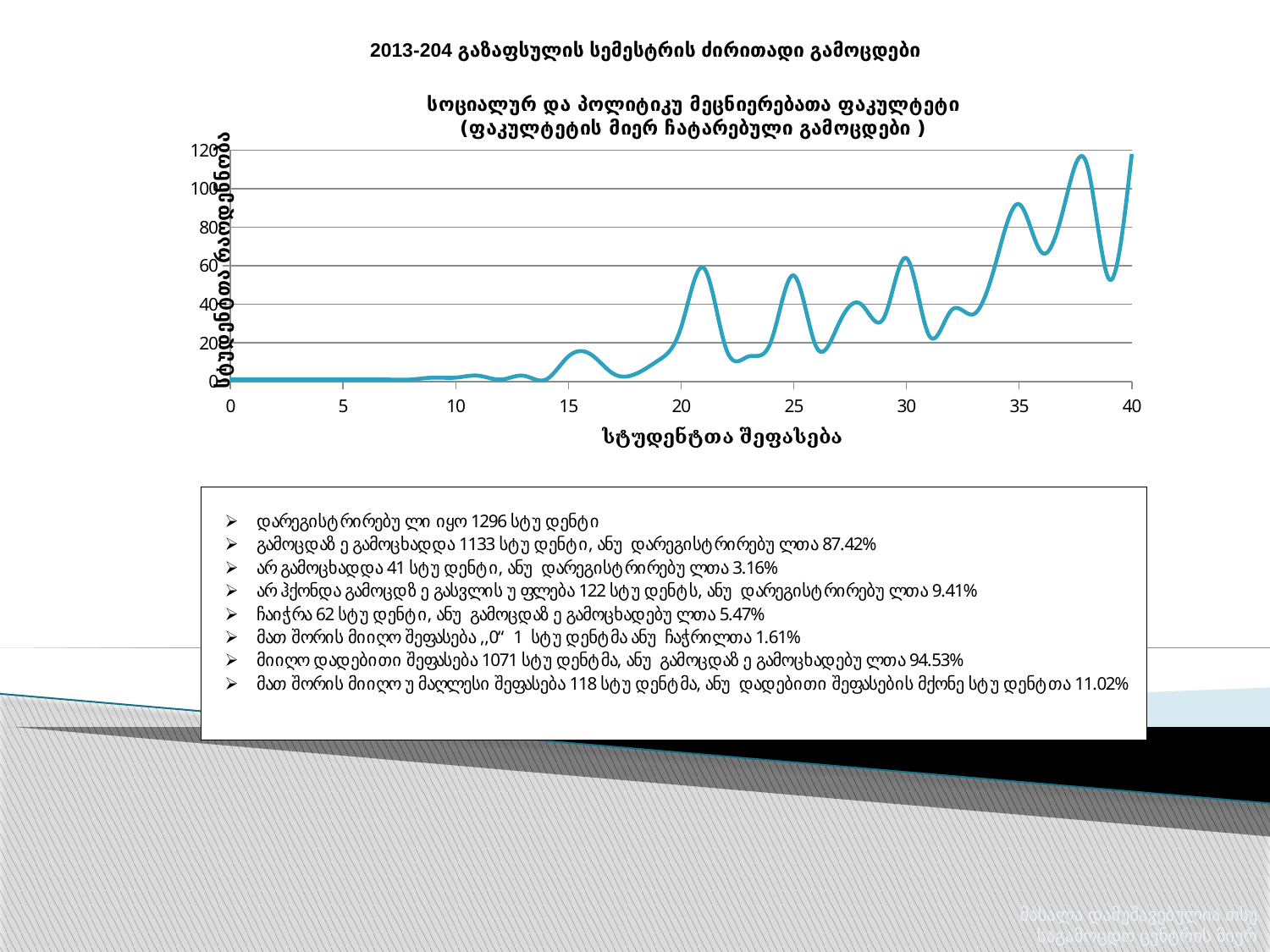
Is the value at x = 25 greater or less than 40? greater Is the value at x = 15 greater or less than 20? less Overall, do the values rise or fall as the x axis goes from 0 to 40? rise Which is larger, the value at x = 35 or the value at x = 10? x = 35 Is the value at x = 40 greater or less than 100? greater What kind of chart is shown on the slide? line chart What is the label of the x axis? სტუდენტთა შეფასება What is the highest tick value shown on the y axis? 120